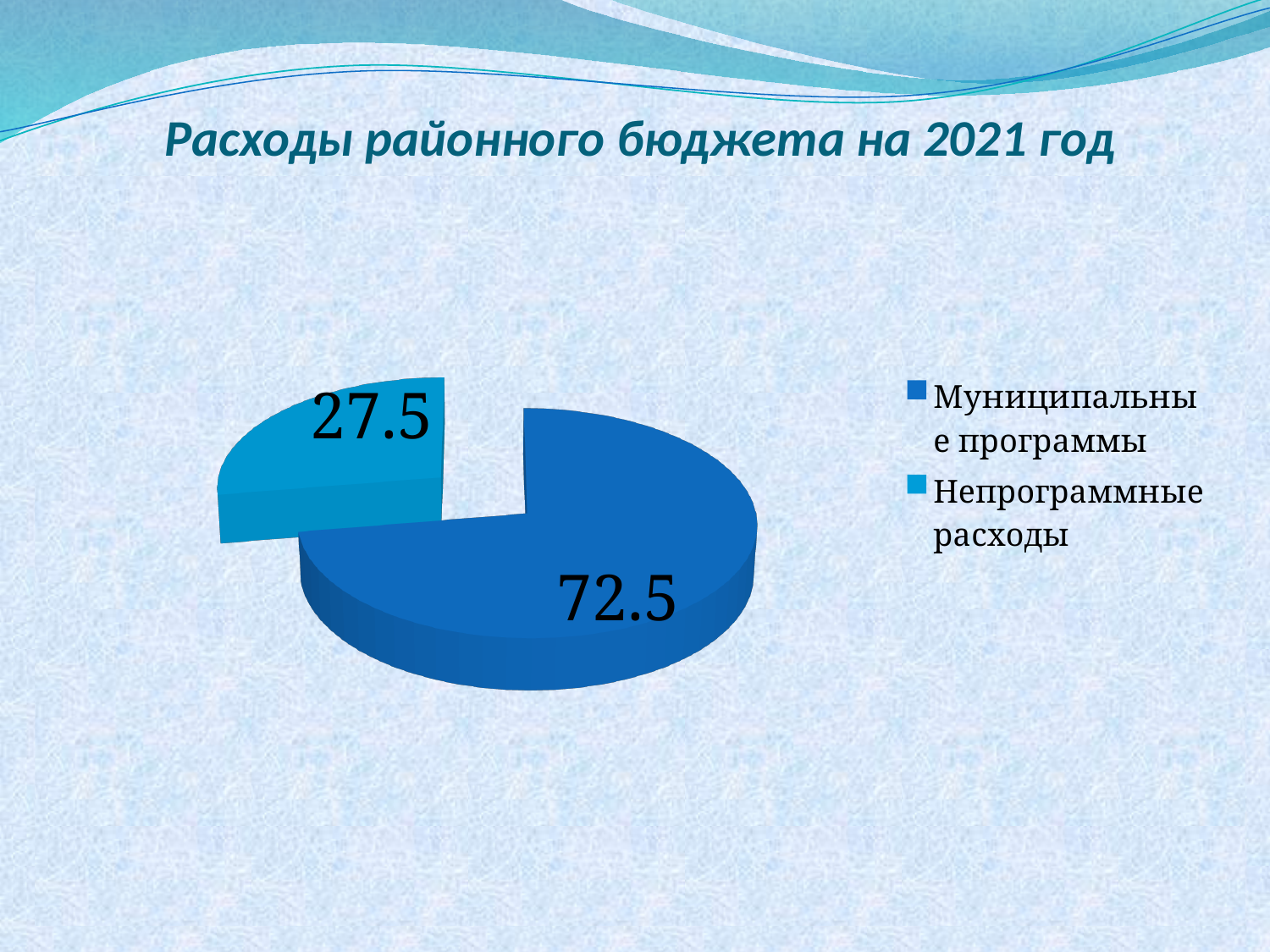
How many entries does the legend list? 2 Which category has the smallest slice? Непрограммные расходы Which category has the largest slice? Муниципальные программы What is the difference between the values for Муниципальные программы and Непрограммные расходы? 45 What is the value for Муниципальные программы? 72.5 What is the total of the two slice values? 100 Which is larger, the value for Муниципальные программы or the value for Непрограммные расходы? Муниципальные программы What kind of chart is shown on the slide? pie chart What is the value for Непрограммные расходы? 27.5 How many slices does the pie chart have? 2 What is the title of the slide? Расходы районного бюджета на 2021 год Which legend entry is shown in the lighter blue colour? Непрограммные расходы